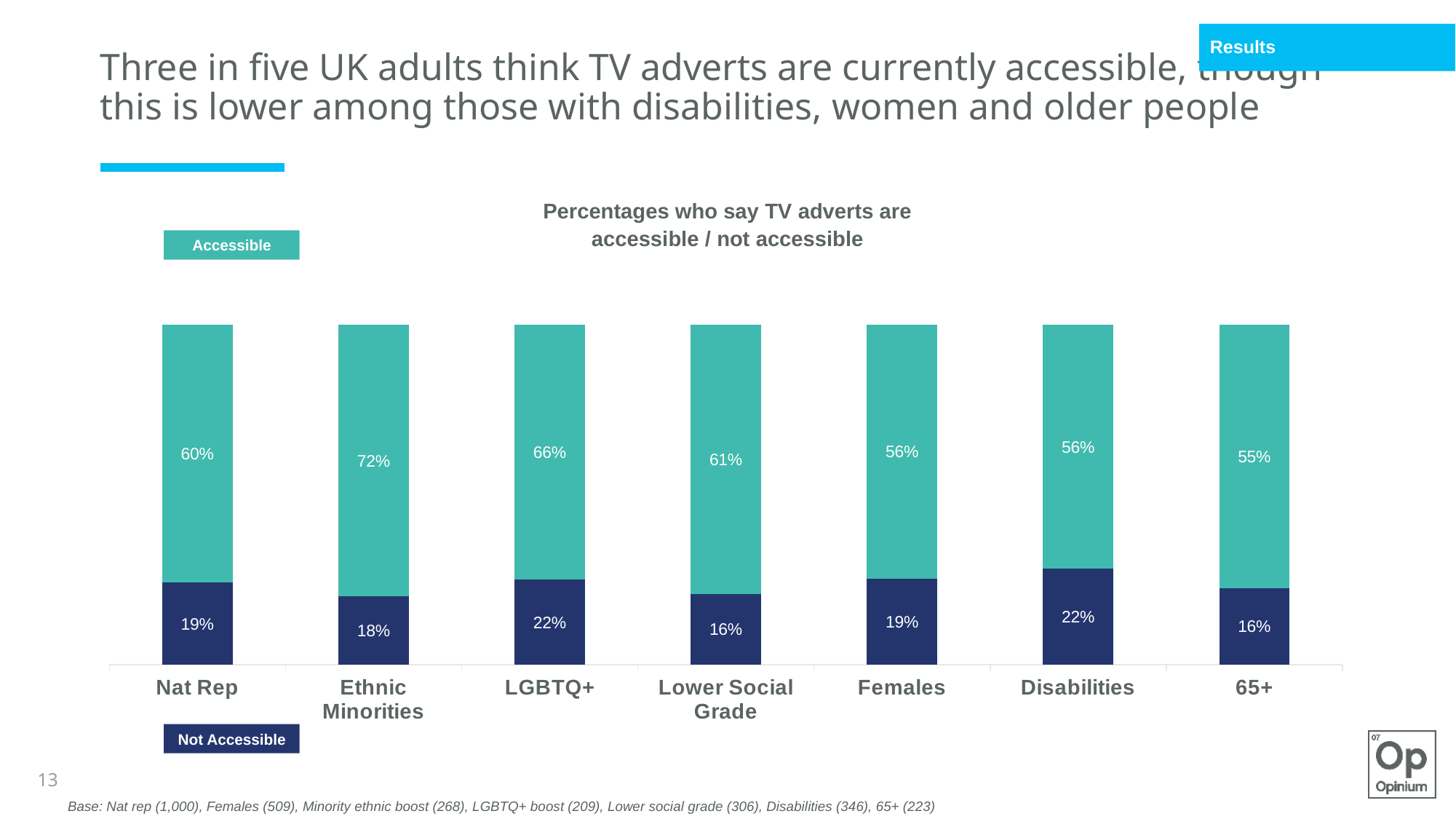
What is the title of the chart? Percentages who say TV adverts are accessible / not accessible What percentage of Nat Rep respondents say TV adverts are accessible? 60% What is the Not Accessible percentage for the Disabilities group? 22% How many percentage points higher is the Accessible value for Ethnic Minorities than for Nat Rep? 12 percentage points Which group has the lowest Accessible percentage? 65+ How many series does the chart show? 2 Which has a higher Accessible percentage, LGBTQ+ or Females? LGBTQ+ How many groups are shown on the x axis of the chart? 7 Which group has the highest Accessible percentage? Ethnic Minorities What is the Not Accessible value for Lower Social Grade? 16% What type of chart is shown on the slide? Stacked bar chart What percentage of the 65+ group say TV adverts are accessible? 55%